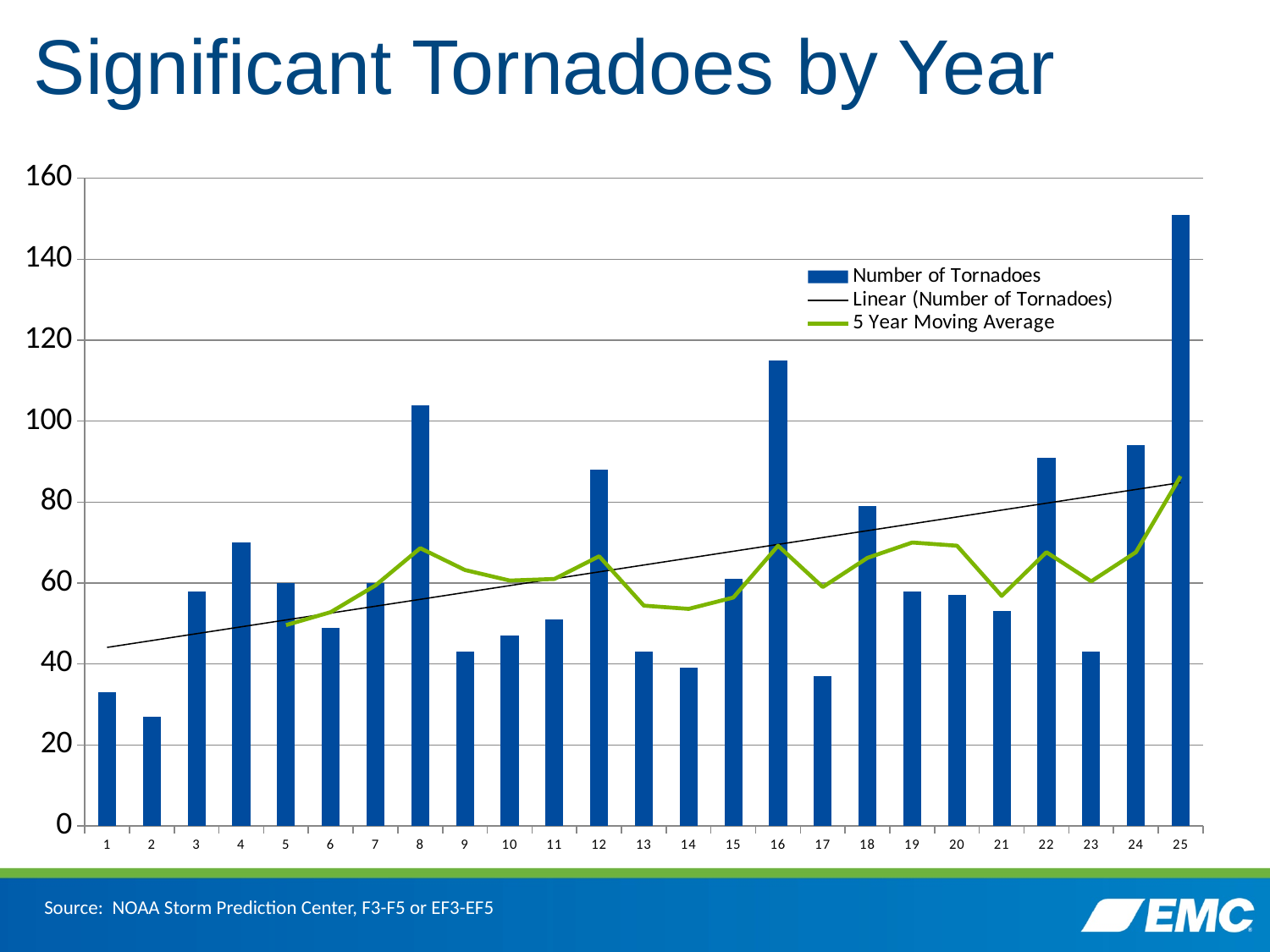
Is the value for category 16 greater or less than 100? greater How many series does the legend list? 3 What kind of chart is shown on the slide? combination bar and line chart Which has a larger number of tornadoes, category 8 or category 16? 16 Is the value for category 22 greater or less than 80? greater Is the value for category 25 greater or less than 140? greater What colour is the 5 Year Moving Average line? green Which category has the highest number of tornadoes? 25 Does the linear trend line rise or fall from left to right? rise How many categories are shown on the x axis? 25 Which category has the lowest number of tornadoes? 2